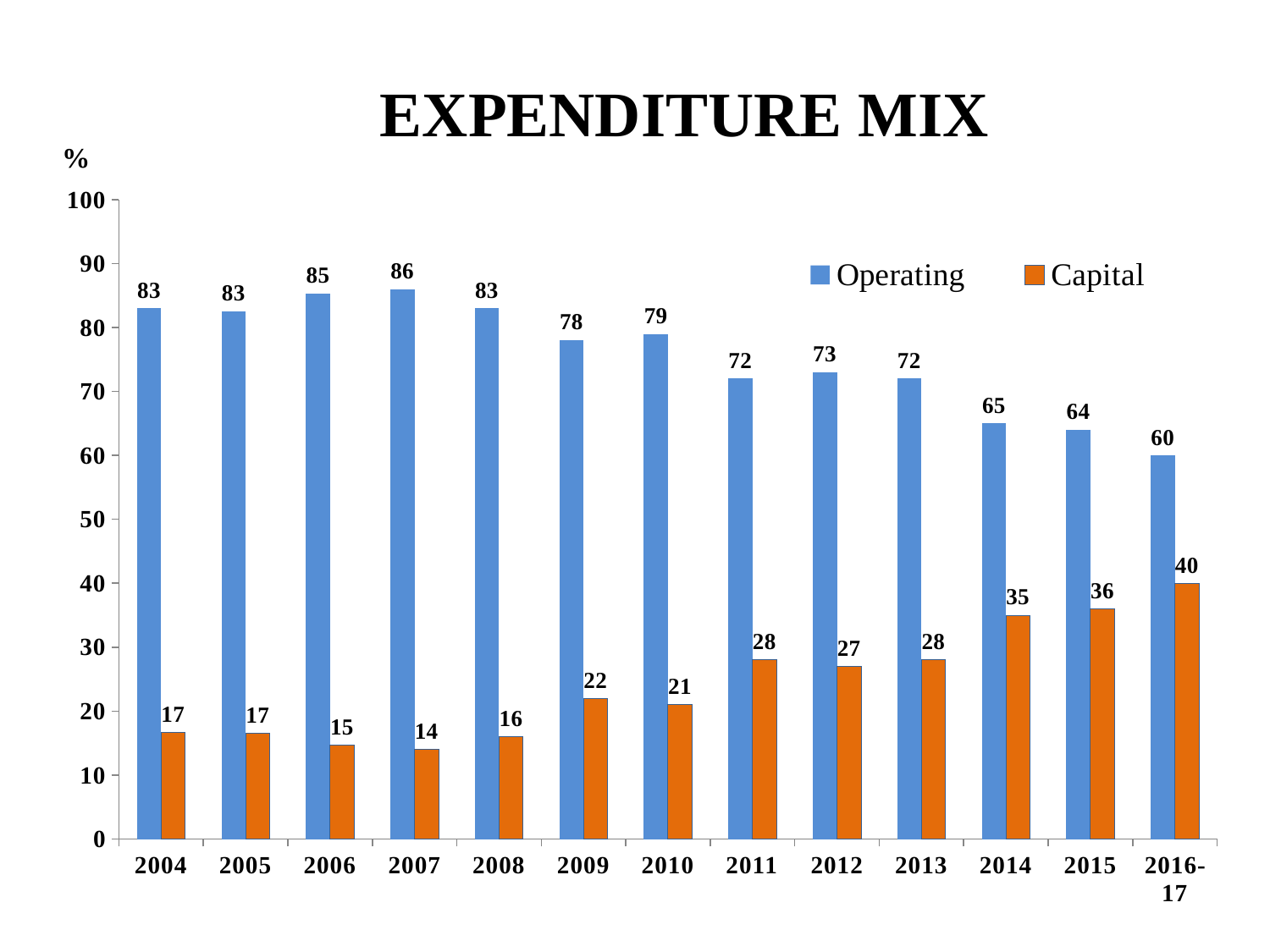
What is the Capital value for 2009? 22 Which year has the lowest Capital value? 2007 What is the Capital value for 2016-17? 40 How many years are shown on the x axis? 13 How many series does the legend list? 2 Does the Capital series generally rise or fall from 2004 to 2016-17? Rise What kind of chart is shown? Bar chart Which year has the highest Operating value? 2007 What is the title of the chart? EXPENDITURE MIX What is the difference between the Operating and Capital values in 2014? 30 Is the Operating value for 2011 larger than the Operating value for 2015? Yes, 2011 What is the Operating value for 2007? 86